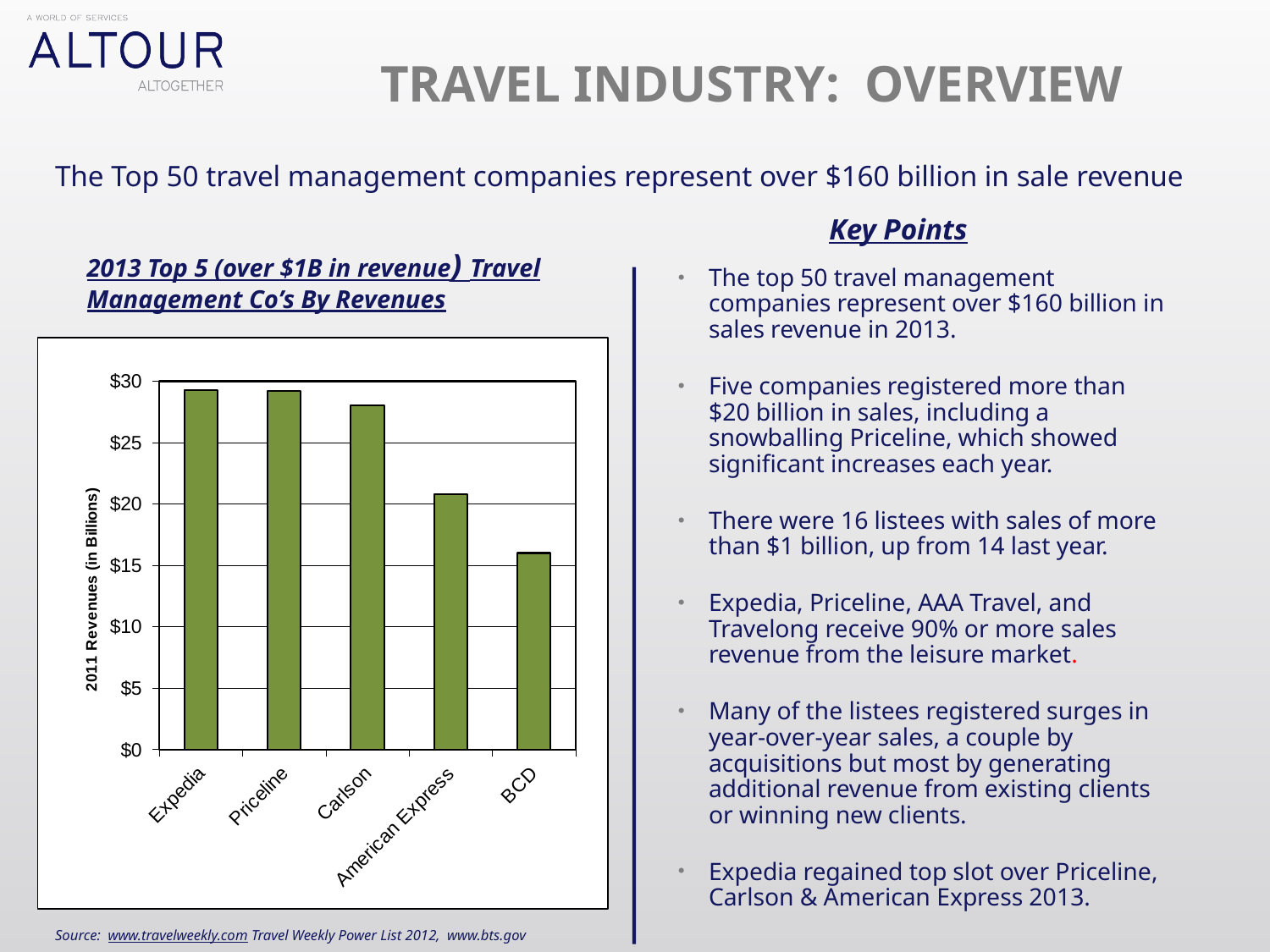
Is the value for BCD greater or less than $20? less How many companies are shown on the chart? 5 Which company has the lowest revenue on the chart? BCD Do the revenue values rise or fall moving from Expedia to BCD along the x axis? fall Is the value for BCD greater or less than $15? greater Is the value for American Express greater or less than $25? less Which has higher revenue on the chart, Carlson or American Express? Carlson Which has higher revenue on the chart, American Express or BCD? American Express What kind of chart is shown on the slide? bar chart What is the label on the vertical axis of the chart? 2011 Revenues (in Billions)